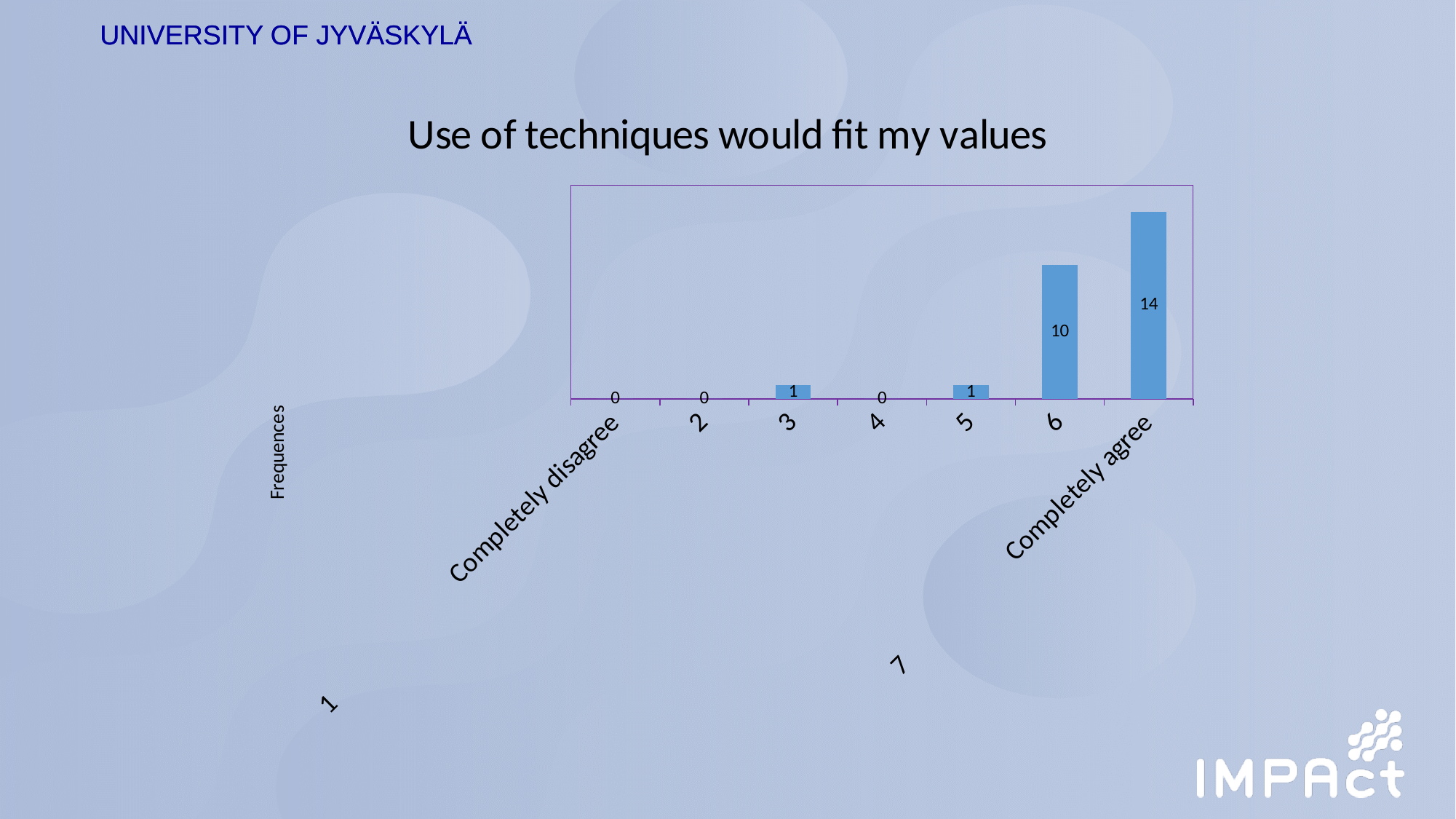
Which category has the highest value? Completely agree What is the value for category 3? 1 Do the values generally rise or fall from "Completely disagree" to "Completely agree"? Rise Which is larger, the value for category 5 or the value for category 6? Category 6 What is the value for "Completely agree"? 14 How many categories are shown on the x axis? 7 What is the value for category 6? 10 What is the label on the vertical axis? Frequences What kind of chart is shown? Bar chart What is the title of the chart? Use of techniques would fit my values What is the difference between the values for "Completely agree" and category 6? 4 What is the value for "Completely disagree"? 0